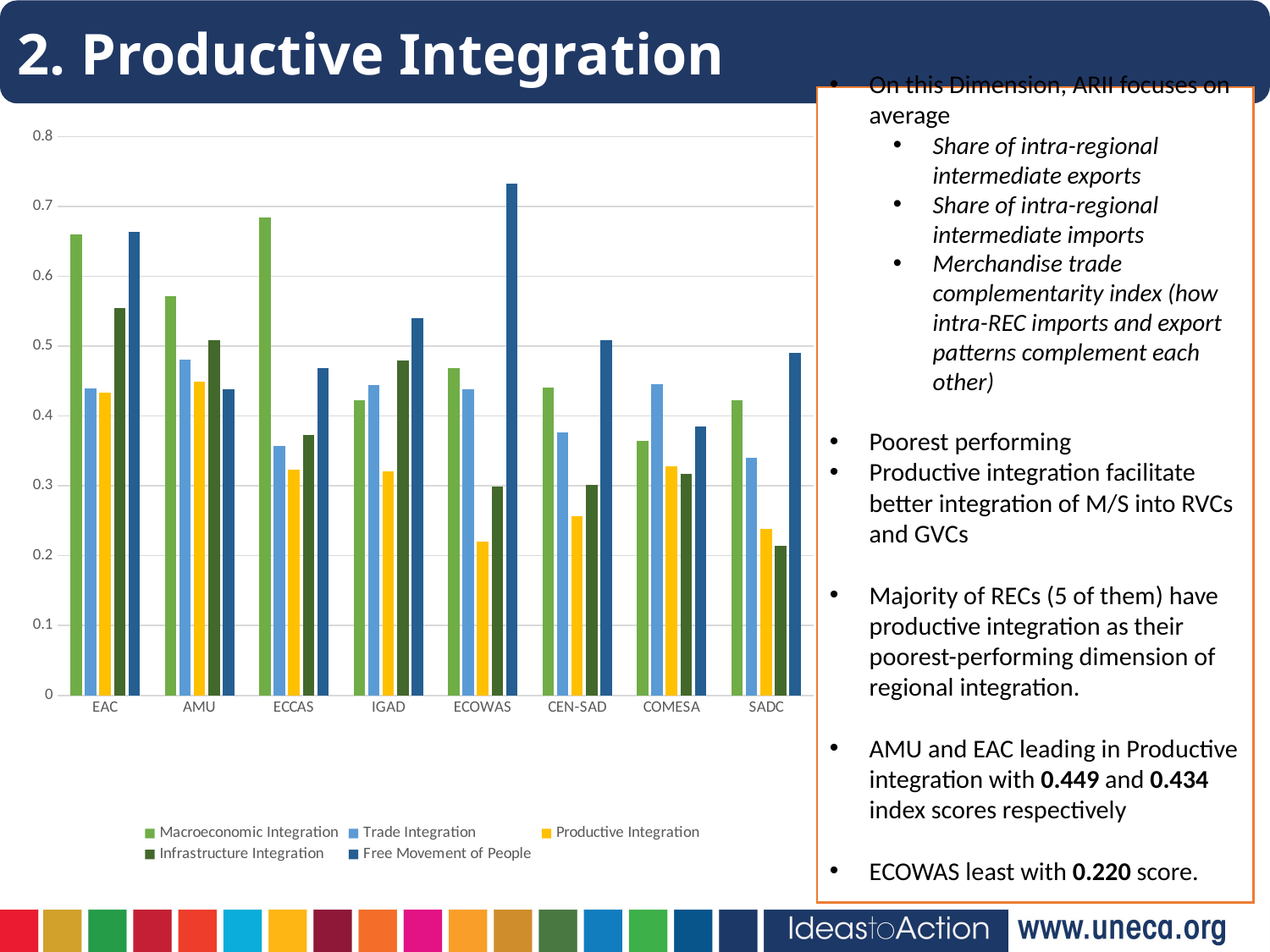
According to the slide, what is the Productive Integration index score for AMU? 0.449 Which is larger, the Trade Integration value for EAC or for AMU? AMU Which REC has the lowest Infrastructure Integration value in the chart? SADC How many series does the chart legend list? 5 How many regional economic communities (categories) are shown on the x axis of the chart? 8 Which REC has the highest Free Movement of People value in the chart? ECOWAS According to the slide, what is the Productive Integration index score for EAC? 0.434 What kind of chart is shown on the slide? bar chart Is the Macroeconomic Integration value for ECCAS greater or less than 0.6? greater Which REC has the lowest Productive Integration score in the chart? ECOWAS According to the slide, what is the Productive Integration score for ECOWAS? 0.220 Is the Free Movement of People value for ECOWAS greater or less than 0.7? greater